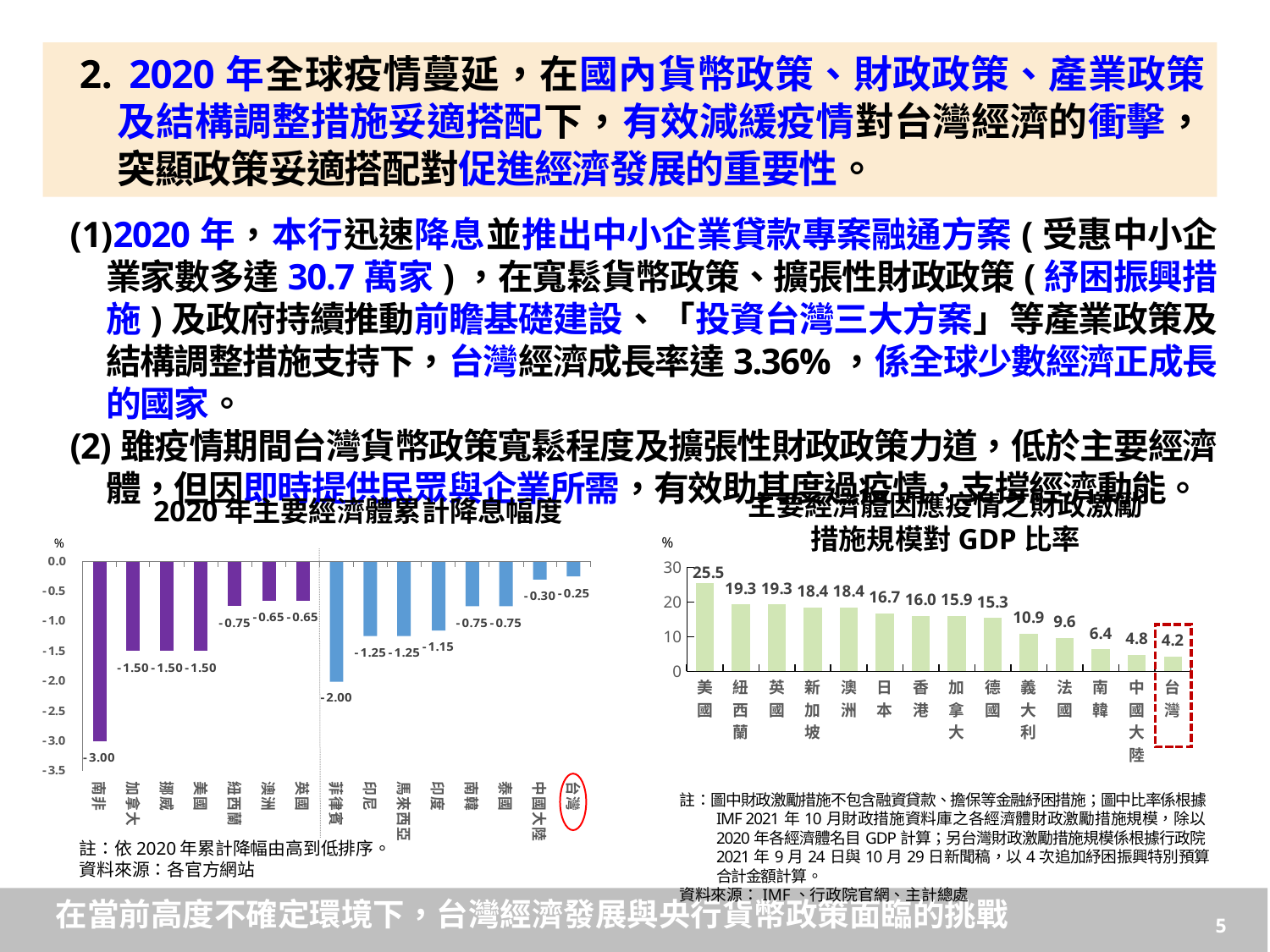
In the chart titled 2020 年主要經濟體累計降息幅度, how many economies are shown? 15 In the chart titled 主要經濟體因應疫情之財政激勵措施規模對 GDP 比率, which economy has the lowest value? 台灣 In the chart titled 主要經濟體因應疫情之財政激勵措施規模對 GDP 比率, which economy has the highest value? 美國 In the chart titled 主要經濟體因應疫情之財政激勵措施規模對 GDP 比率, which is larger, the value for 日本 or the value for 義大利? 日本 In the chart titled 2020 年主要經濟體累計降息幅度, what kind of chart is it? Bar chart In the chart titled 主要經濟體因應疫情之財政激勵措施規模對 GDP 比率, what is the difference between the values for 美國 and 台灣? 21.3 In the chart titled 2020 年主要經濟體累計降息幅度, what is the value for 菲律賓? -2.00 In the chart titled 主要經濟體因應疫情之財政激勵措施規模對 GDP 比率, how many economies are shown? 14 In the chart titled 2020 年主要經濟體累計降息幅度, what is the value for 台灣? -0.25 In the chart titled 2020 年主要經濟體累計降息幅度, which economy has the largest cumulative rate cut (lowest value)? 南非 In the chart titled 2020 年主要經濟體累計降息幅度, what is the difference between the values for 南非 and 台灣? 2.75 In the chart titled 主要經濟體因應疫情之財政激勵措施規模對 GDP 比率, what is the value for 台灣? 4.2